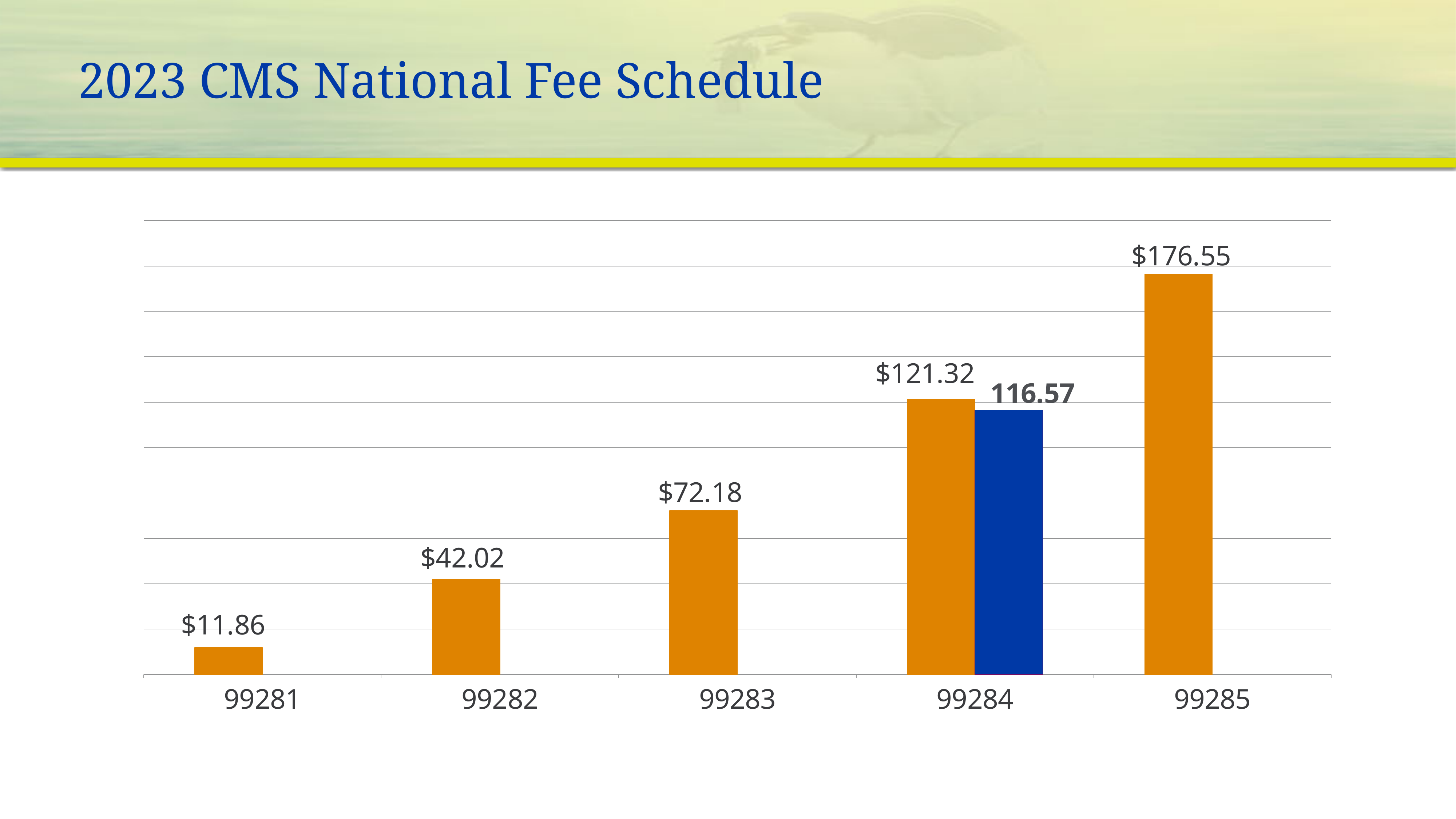
What value is labelled on the blue bar at 99284? 116.57 At 99284, what is the difference between the orange bar ($121.32) and the blue bar (116.57)? 4.75 Do the orange bar values rise or fall from 99281 to 99285? Rise What kind of chart is shown on the slide? Bar chart Which category has the lowest orange bar? 99281 What is the difference between the orange bar values for 99285 and 99284? $55.23 What is the title of the slide containing the chart? 2023 CMS National Fee Schedule What is the value of the orange bar for 99281? $11.86 Which is larger at 99284: the orange bar or the blue bar? The orange bar How many categories are shown on the x axis? 5 Which category has the highest orange bar? 99285 What is the value of the orange bar for 99283? $72.18